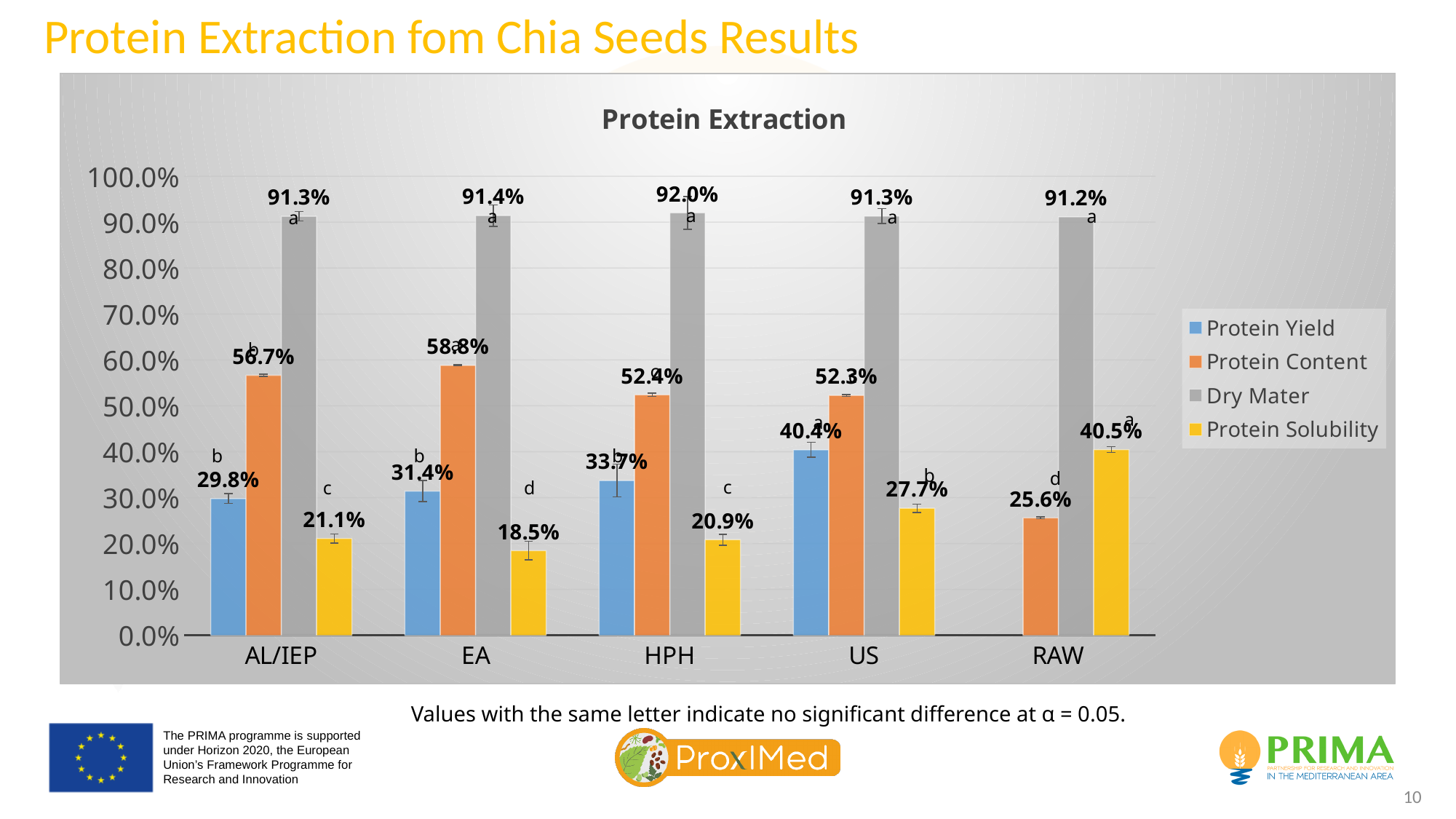
How many series does the legend list? 4 What kind of chart is shown on the slide? bar chart How many categories are shown on the x axis? 5 What is the Dry Mater value for HPH? 92.0% Which category has the highest Dry Mater value? HPH Which has the larger Protein Yield, AL/IEP or EA? EA What is the Protein Content value for RAW? 25.6% Is the Protein Solubility value for RAW greater or less than 30.0%? greater What is the Protein Solubility value for EA? 18.5% What is the Protein Yield value for AL/IEP? 29.8% Which category has the lowest Protein Solubility value? EA What is the difference between the Protein Solubility values for AL/IEP and EA? 2.6 percentage points